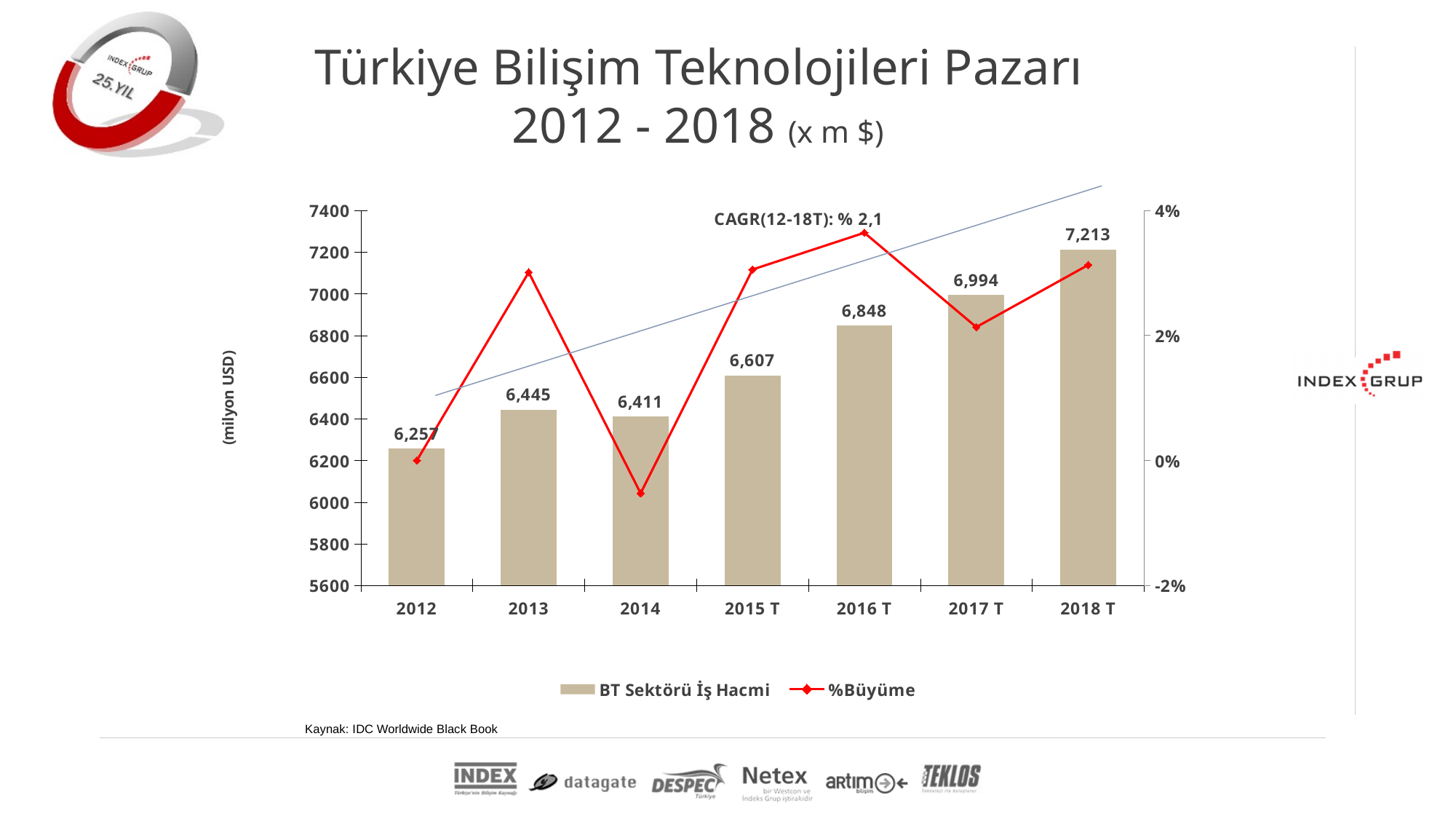
What is the value of BT Sektörü İş Hacmi for 2012? 6,257 Is the %Büyüme value for 2016 T greater or less than 2%? greater What is the difference in BT Sektörü İş Hacmi between 2018 T and 2012? 956 Which is larger, the BT Sektörü İş Hacmi for 2013 or for 2014? 2013 Is the %Büyüme value for 2014 greater or less than 0%? less What CAGR value is printed on the chart? % 2,1 What is the value of BT Sektörü İş Hacmi for 2015 T? 6,607 How many years are shown on the x axis? 7 What is the value of BT Sektörü İş Hacmi for 2018 T? 7,213 How many series does the legend list? 2 Which year has the highest BT Sektörü İş Hacmi? 2018 T Which year has the lowest BT Sektörü İş Hacmi? 2012